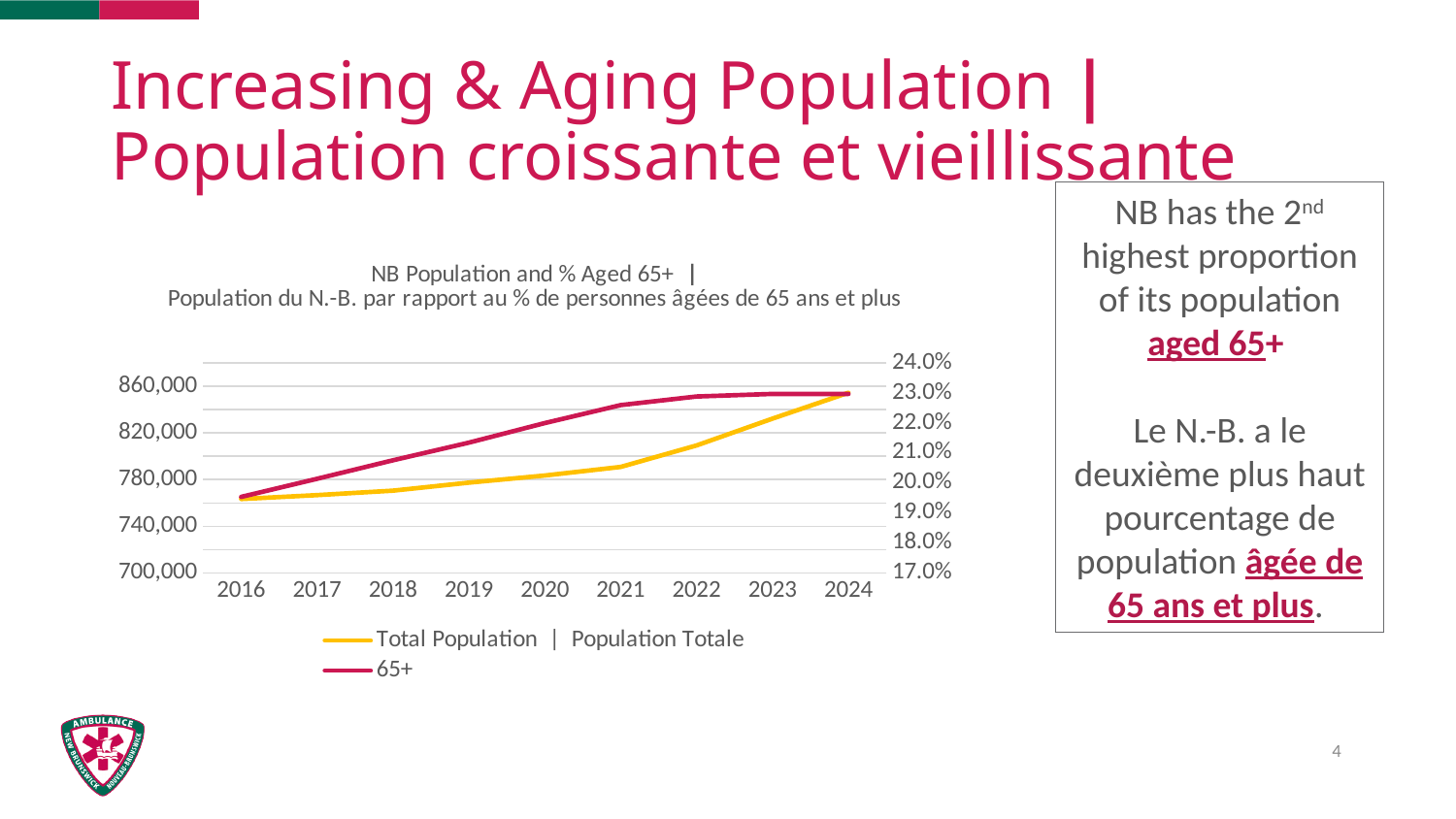
Is the Total Population in 2024 greater or less than 820,000? greater Is the Total Population in 2016 greater or less than 780,000? less Which year has the lowest value for the 65+ series? 2016 What is the title of the chart? NB Population and % Aged 65+ | Population du N.-B. par rapport au % de personnes âgées de 65 ans et plus Is the 65+ value in 2016 greater or less than 20.0%? less Which year has the lowest Total Population? 2016 Is the Total Population larger in 2020 or in 2022? 2022 What kind of chart is shown on the slide? Line chart Which year has the highest Total Population? 2024 Does the Total Population rise or fall from 2016 to 2024? Rise How many series does the legend list? 2 How many years are shown along the x axis? 9